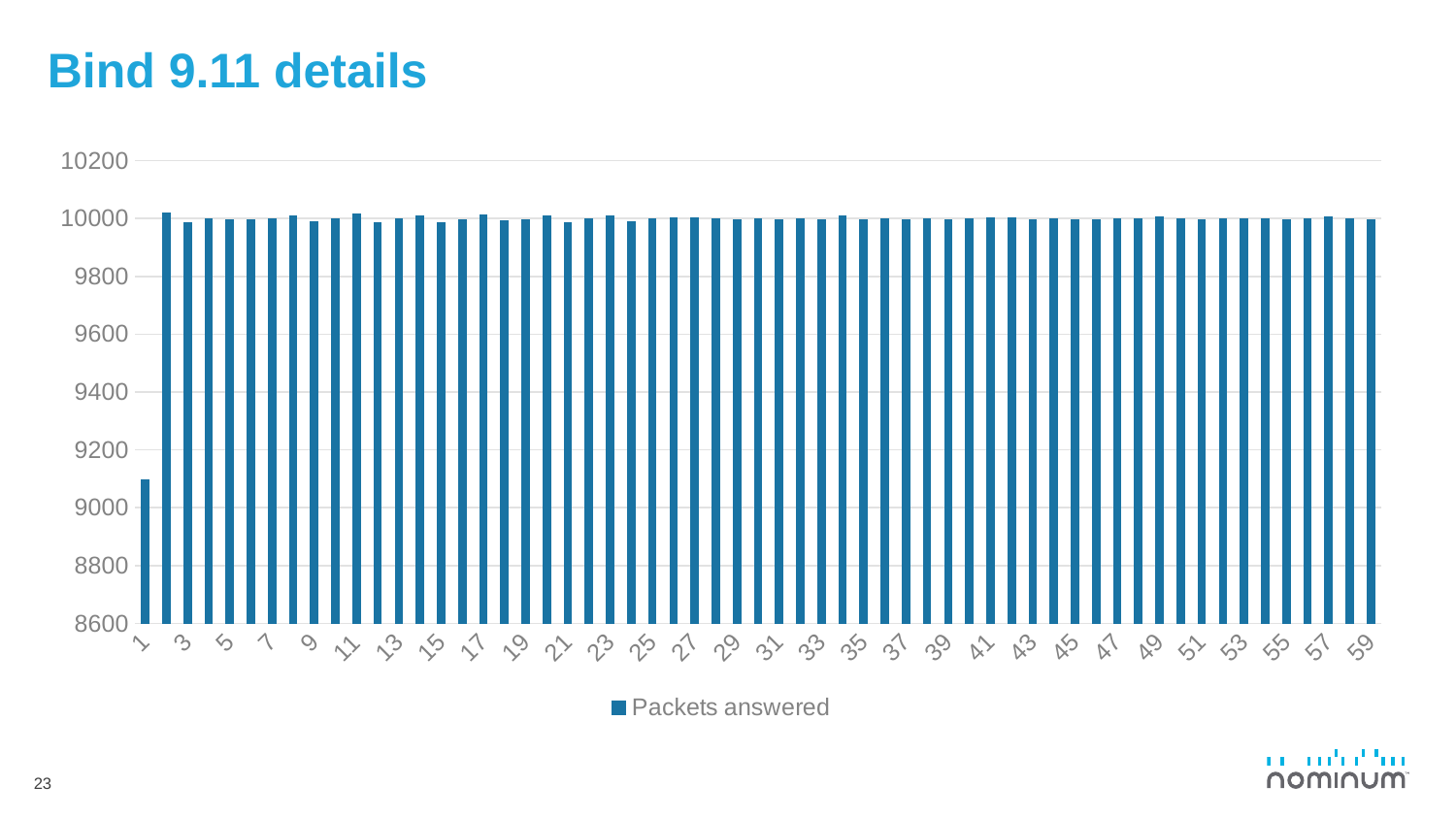
What is the name of the series shown in the legend? Packets answered What kind of chart is shown on the slide? bar chart Which has the larger value for Packets answered, category 1 or category 29? 29 What is the title of the slide containing the chart? Bind 9.11 details Is the value for category 1 greater or less than 9000? greater Is the value for category 59 greater or less than 9600? greater How many series does the legend list? 1 Is the value for category 3 greater or less than 9800? greater What is the lowest value shown on the vertical axis? 8600 Which has the larger value for Packets answered, category 1 or category 3? 3 Which category has the lowest value for Packets answered? 1